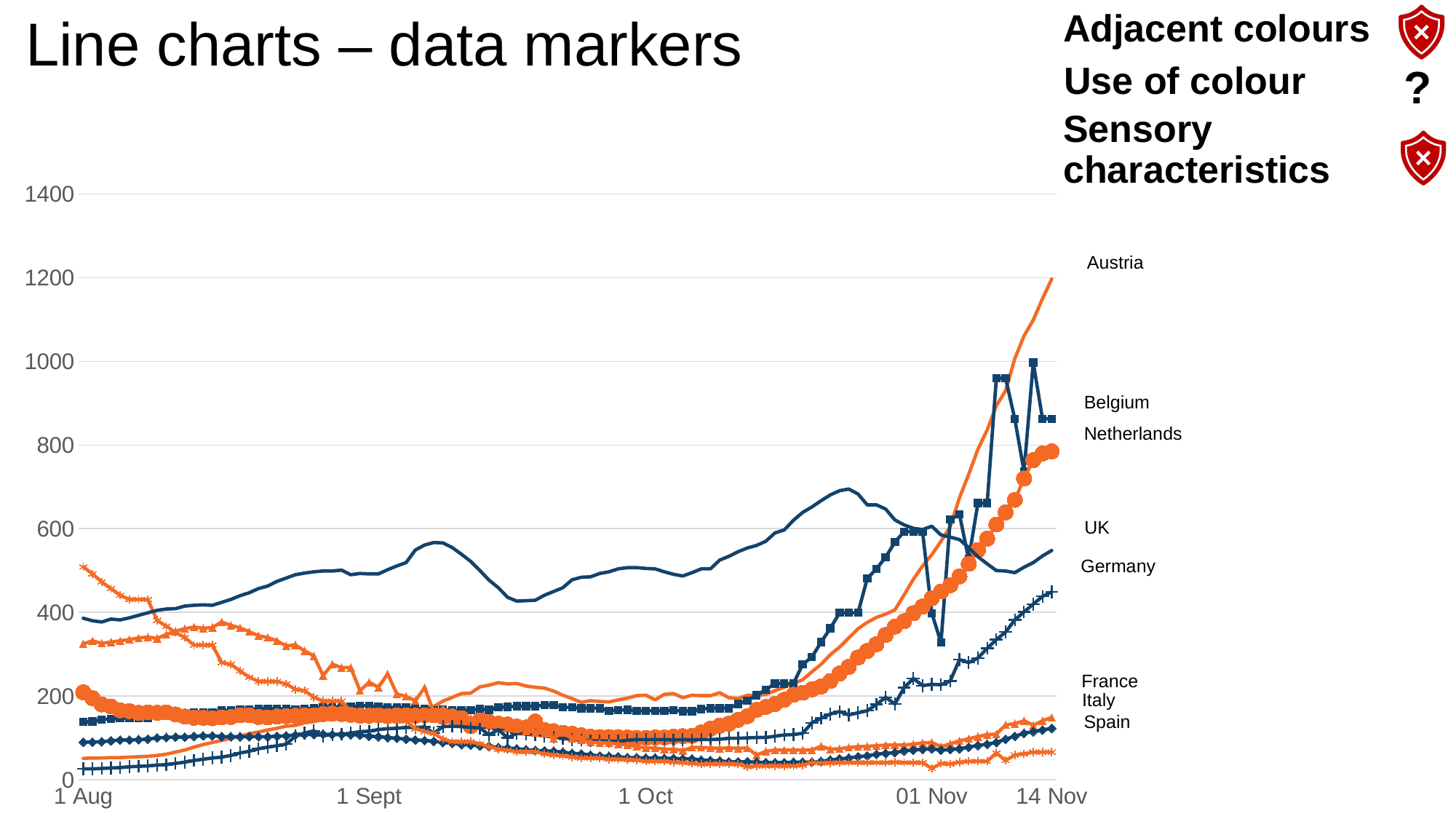
How many countries are labelled on the chart? 8 How many date labels are shown on the x axis? 5 At 14 Nov, which is higher: Austria or Belgium? Austria Is the value for Austria at 14 Nov greater or less than 1000? greater Is the value for Netherlands at 14 Nov greater or less than 600? greater Does the Austria line rise or fall between 1 Oct and 14 Nov? rises Is the value for Belgium at 14 Nov greater or less than 800? greater What type of chart is shown on the slide? Line chart Which two colours are used for the lines in the chart? Navy blue and orange Which country has the highest value at 14 Nov? Austria What is the title of the slide? Line charts – data markers